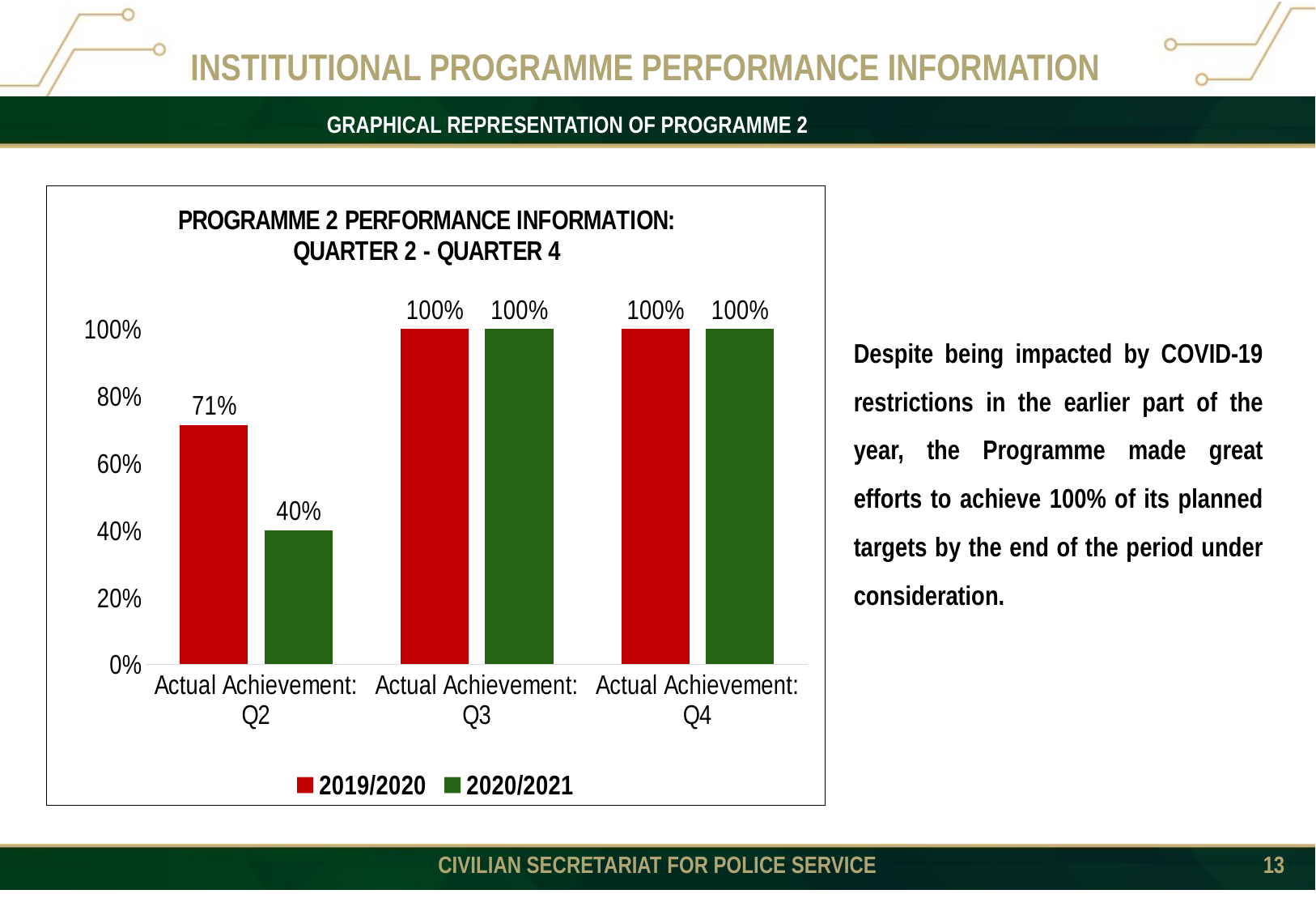
What is the title of the chart? PROGRAMME 2 PERFORMANCE INFORMATION: QUARTER 2 - QUARTER 4 What is the 2019/2020 value for Actual Achievement: Q2? 71% For Actual Achievement: Q2, which series has the larger value, 2019/2020 or 2020/2021? 2019/2020 What is the 2020/2021 value for Actual Achievement: Q3? 100% Do the 2020/2021 values rise or fall from Q2 to Q4? Rise How many series does the legend list? 2 What is the difference between the 2019/2020 and 2020/2021 values for Actual Achievement: Q2? 31% How many categories are shown on the x axis? 3 Which category has the lowest 2020/2021 value? Actual Achievement: Q2 What kind of chart is shown on the slide? Bar chart What is the 2019/2020 value for Actual Achievement: Q4? 100% What is the 2020/2021 value for Actual Achievement: Q2? 40%